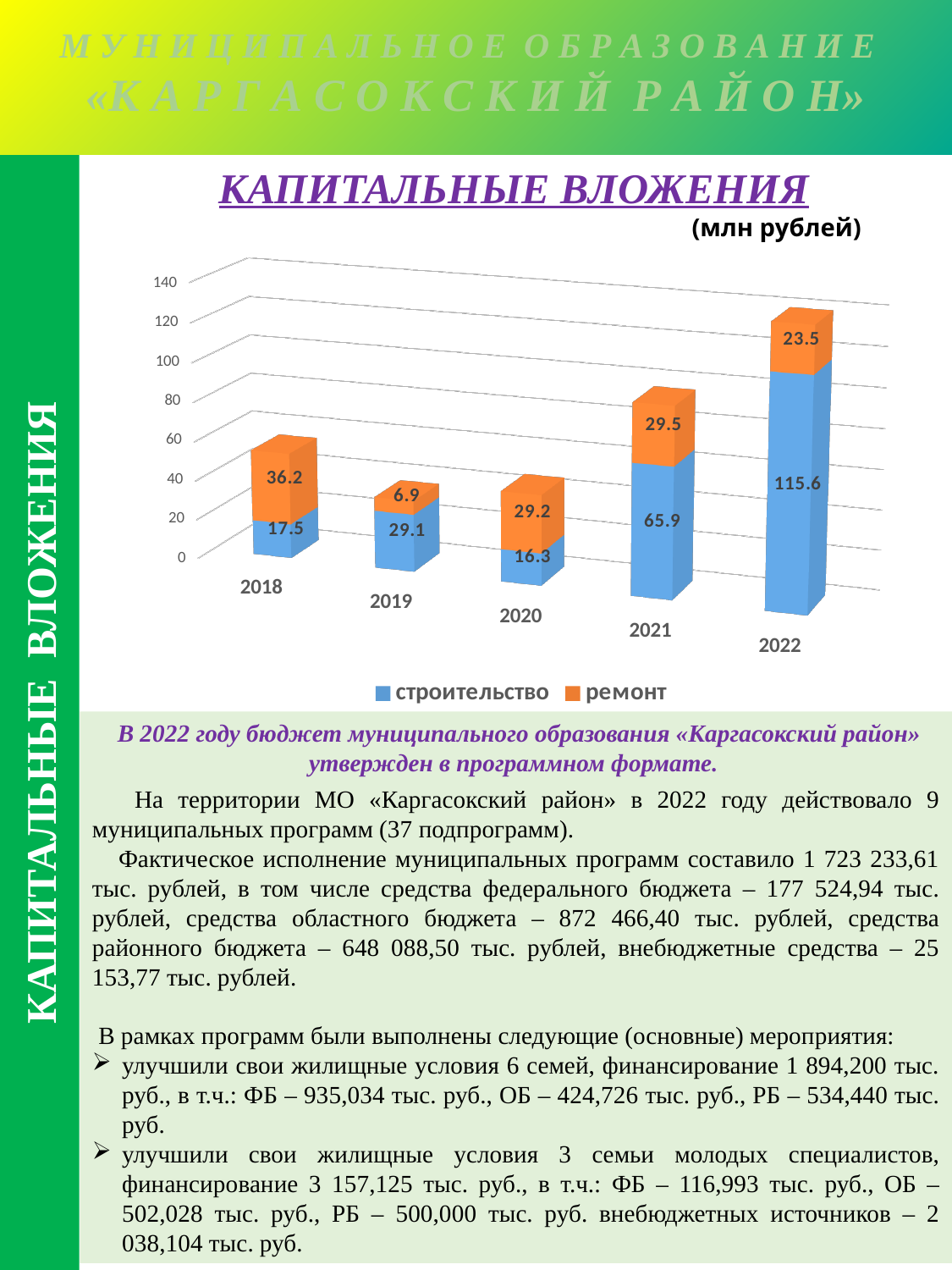
What is the value for строительство in 2020? 16.3 What is the value for ремонт in 2018? 36.2 What is the total of the stacked bar for 2021? 95.4 What unit is given under the chart title? млн рублей What kind of chart is shown on the slide? Stacked bar chart Which is larger in 2018: строительство or ремонт? ремонт Which year has the lowest value for ремонт? 2019 How many series does the legend list? 2 What is the value for строительство in 2022? 115.6 Which year has the highest value for строительство? 2022 How many years are shown on the x axis? 5 What is the difference between the строительство values for 2022 and 2021? 49.7